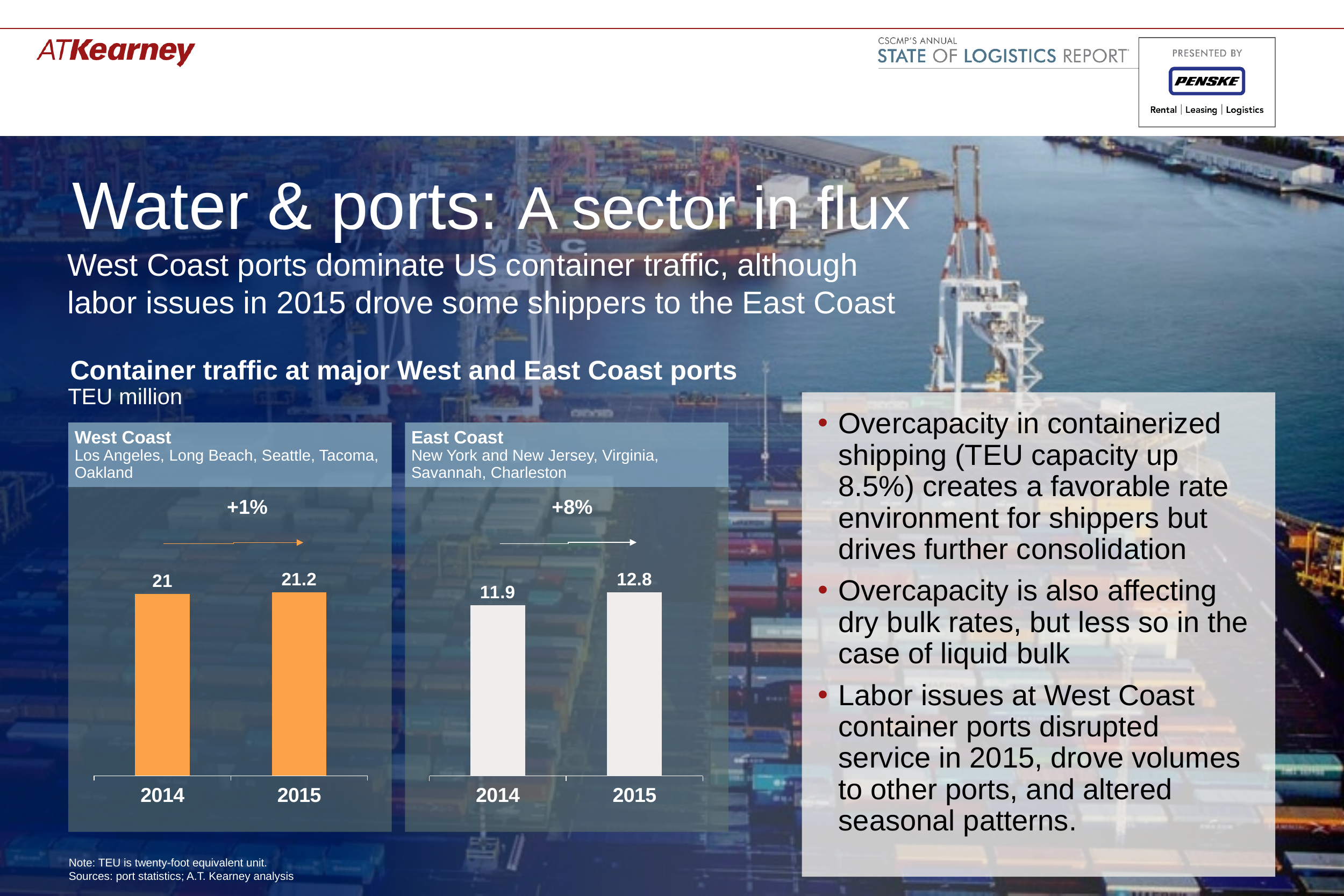
What kind of chart is used to show container traffic at West and East Coast ports? bar chart In the East Coast chart, what is the container traffic value for 2015? 12.8 In the East Coast chart, what is the difference between the 2015 and 2014 values? 0.9 In the East Coast chart, which year has the higher value, 2014 or 2015? 2015 In the East Coast chart, what is the container traffic value for 2014? 11.9 What percentage change is labeled on the East Coast chart? +8% How many years are shown in the West Coast chart? 2 In the East Coast chart, do values rise or fall from 2014 to 2015? rise Which is larger: the West Coast value for 2015 or the East Coast value for 2015? West Coast 2015 In the West Coast chart, what is the container traffic value for 2015? 21.2 In the West Coast chart, what is the difference between the 2015 and 2014 values? 0.2 In the West Coast chart, what is the container traffic value for 2014? 21